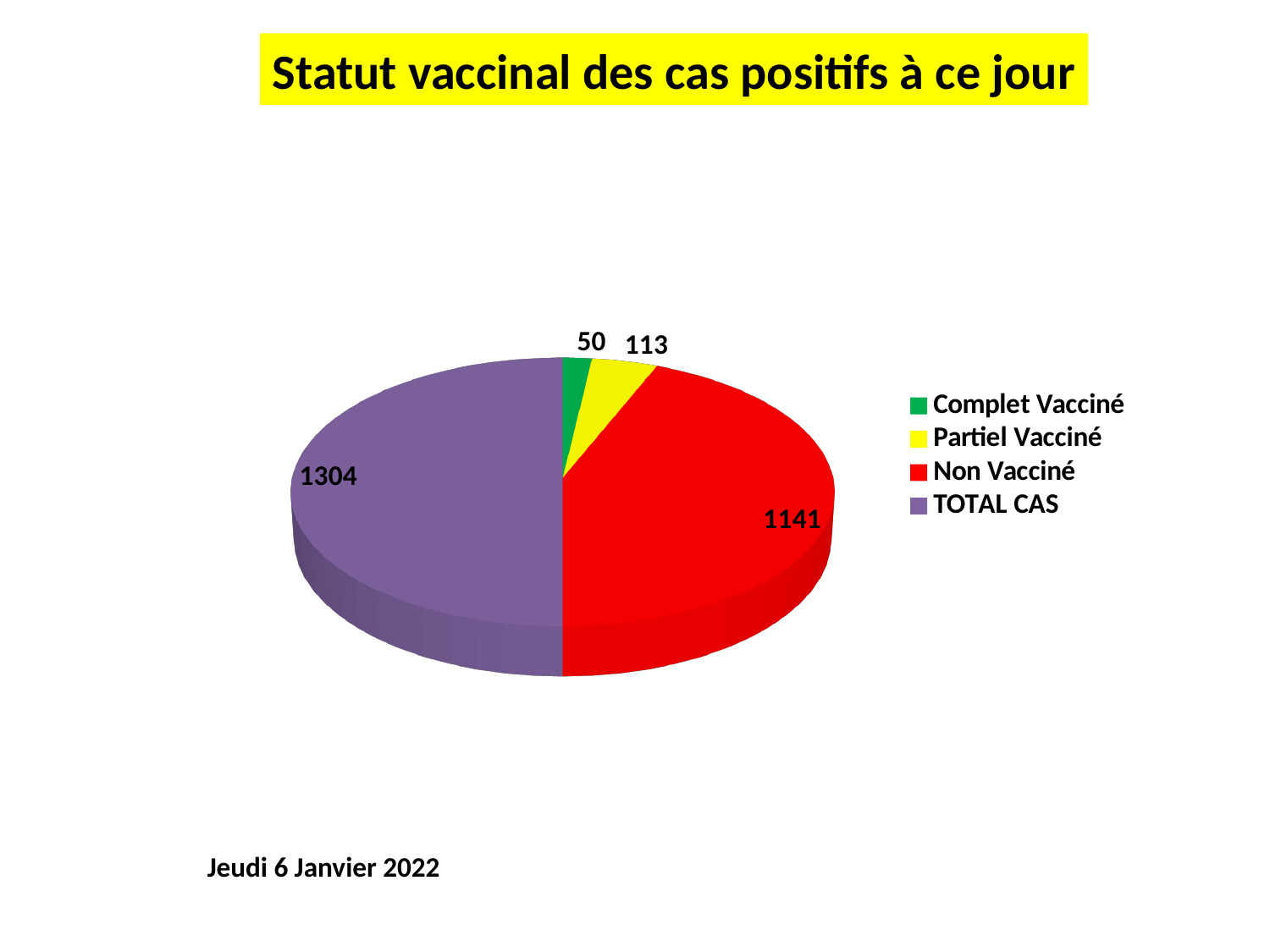
Which category has the smallest slice in the pie chart? Complet Vacciné What is the value for TOTAL CAS? 1304 What is the title of the chart on the slide? Statut vaccinal des cas positifs à ce jour What type of chart is shown on the slide? pie chart Which is larger, the value for Partiel Vacciné or the value for Complet Vacciné? Partiel Vacciné What is the value for Complet Vacciné? 50 What is the value for Non Vacciné? 1141 How many entries does the legend list? 4 How many slices does the pie chart have? 4 What is the value for Partiel Vacciné? 113 Which category has the largest slice in the pie chart? TOTAL CAS What is the difference between the values for Non Vacciné and Partiel Vacciné? 1028